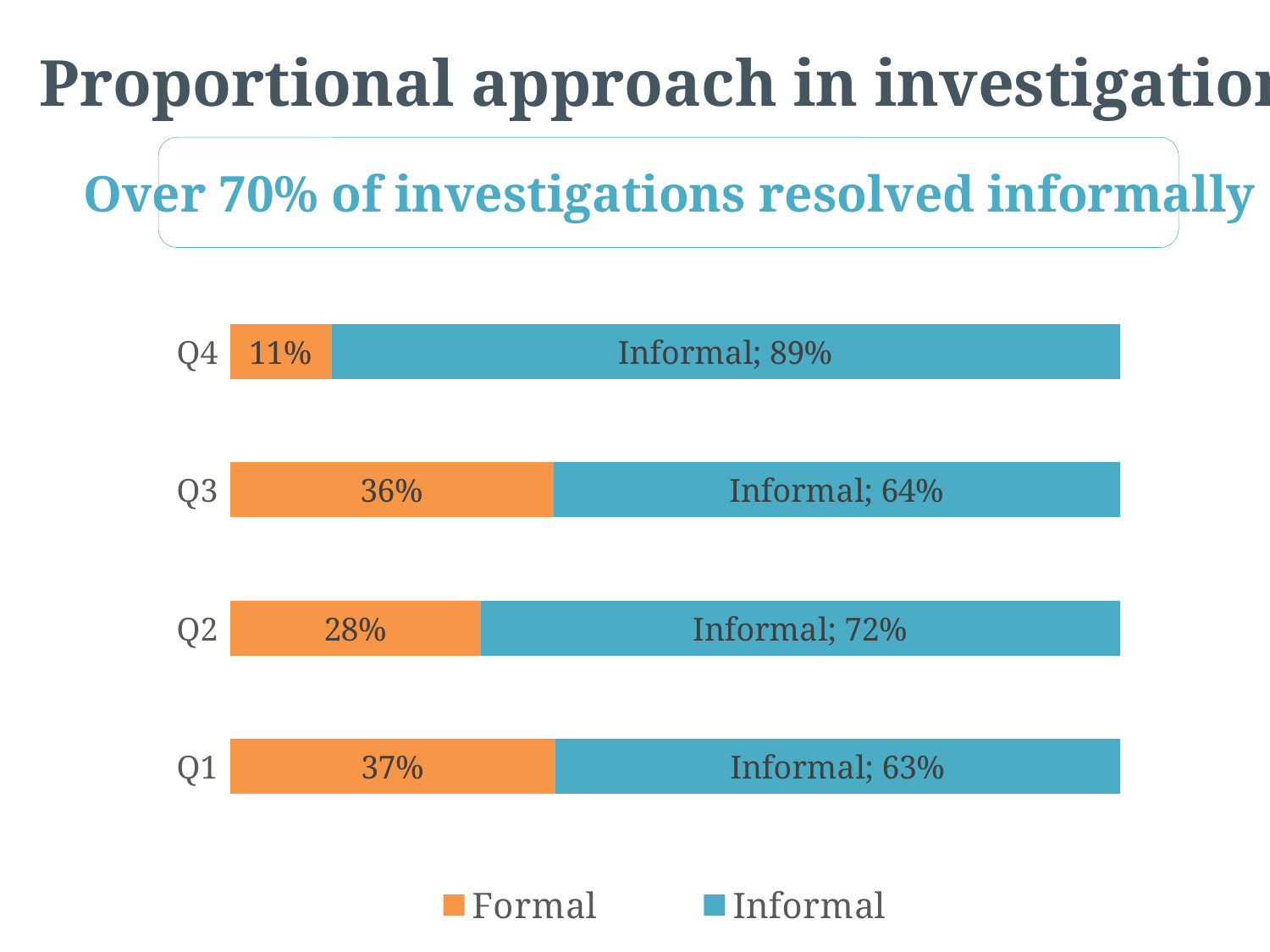
What is the Formal value for Q1? 37% How many quarters are shown in the chart? 4 How many series does the legend list? 2 Which quarter has the highest Informal value? Q4 Which quarter has the lowest Formal value? Q4 What kind of chart is shown on the slide? Stacked bar chart What is the Formal value for Q2? 28% What is the Informal value for Q3? 64% What is the total of the stacked bar for Q2? 100% What is the Informal value for Q4? 89% Which is larger, the Formal value for Q3 or the Formal value for Q2? Q3 What is the difference between the Informal values for Q4 and Q1? 26%